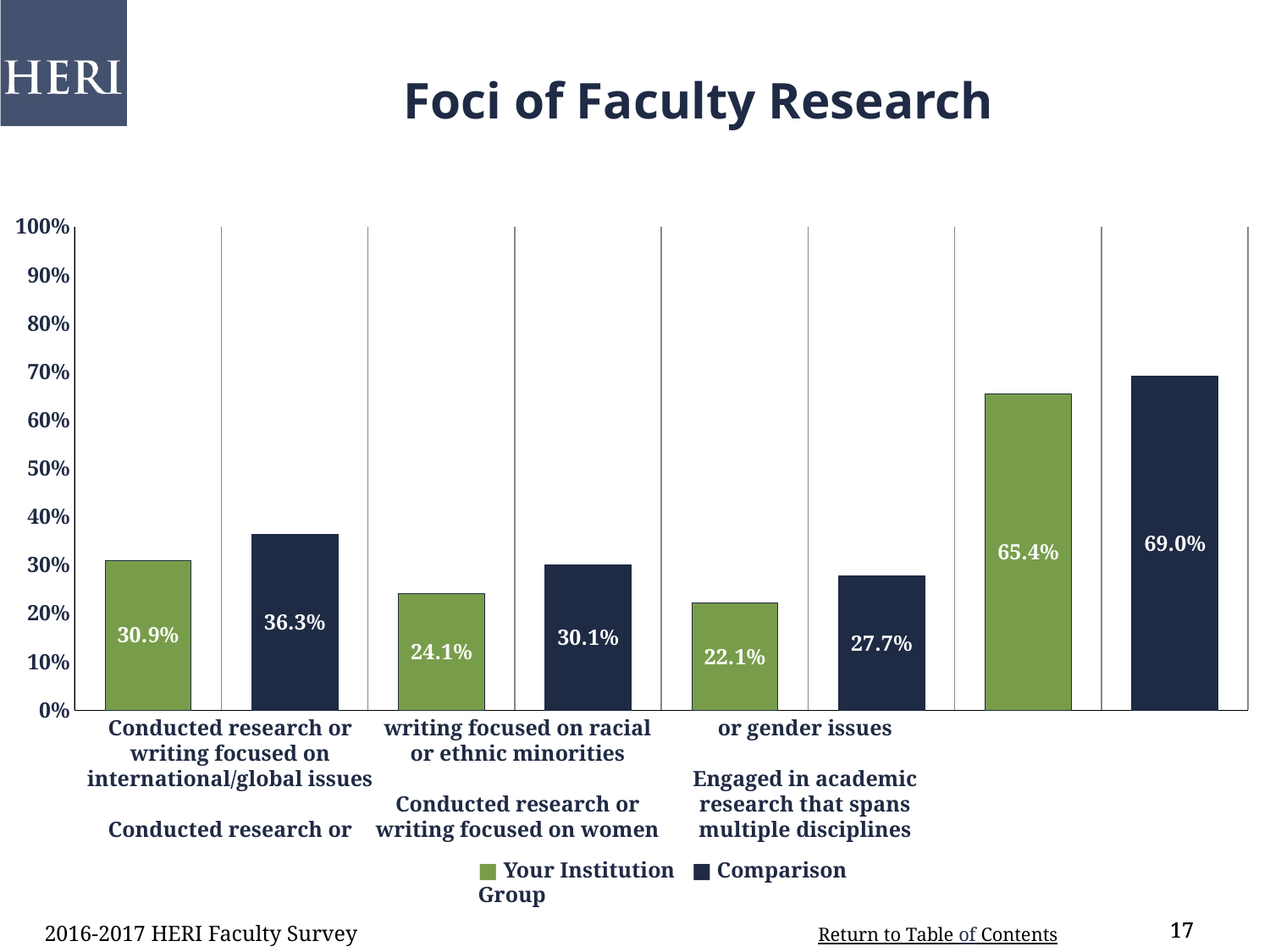
How many series does the legend list? 2 How many categories are plotted on the x axis? 4 What is the title of the chart? Foci of Faculty Research For 'Conducted research or writing focused on racial or ethnic minorities', which is larger: Your Institution or Comparison Group? Comparison Group What type of chart is shown on the slide? bar chart What is the Comparison Group value for 'Engaged in academic research that spans multiple disciplines'? 69.0% What is the Your Institution value for 'Engaged in academic research that spans multiple disciplines'? 65.4% What is the value for Your Institution for 'Conducted research or writing focused on international/global issues'? 30.9% Which category has the lowest Your Institution value? Conducted research or writing focused on women or gender issues What is the difference between the Comparison Group and Your Institution values for 'Conducted research or writing focused on international/global issues'? 5.4% Is the Your Institution value for 'Engaged in academic research that spans multiple disciplines' greater or less than 60%? greater Which category has the highest Comparison Group value? Engaged in academic research that spans multiple disciplines